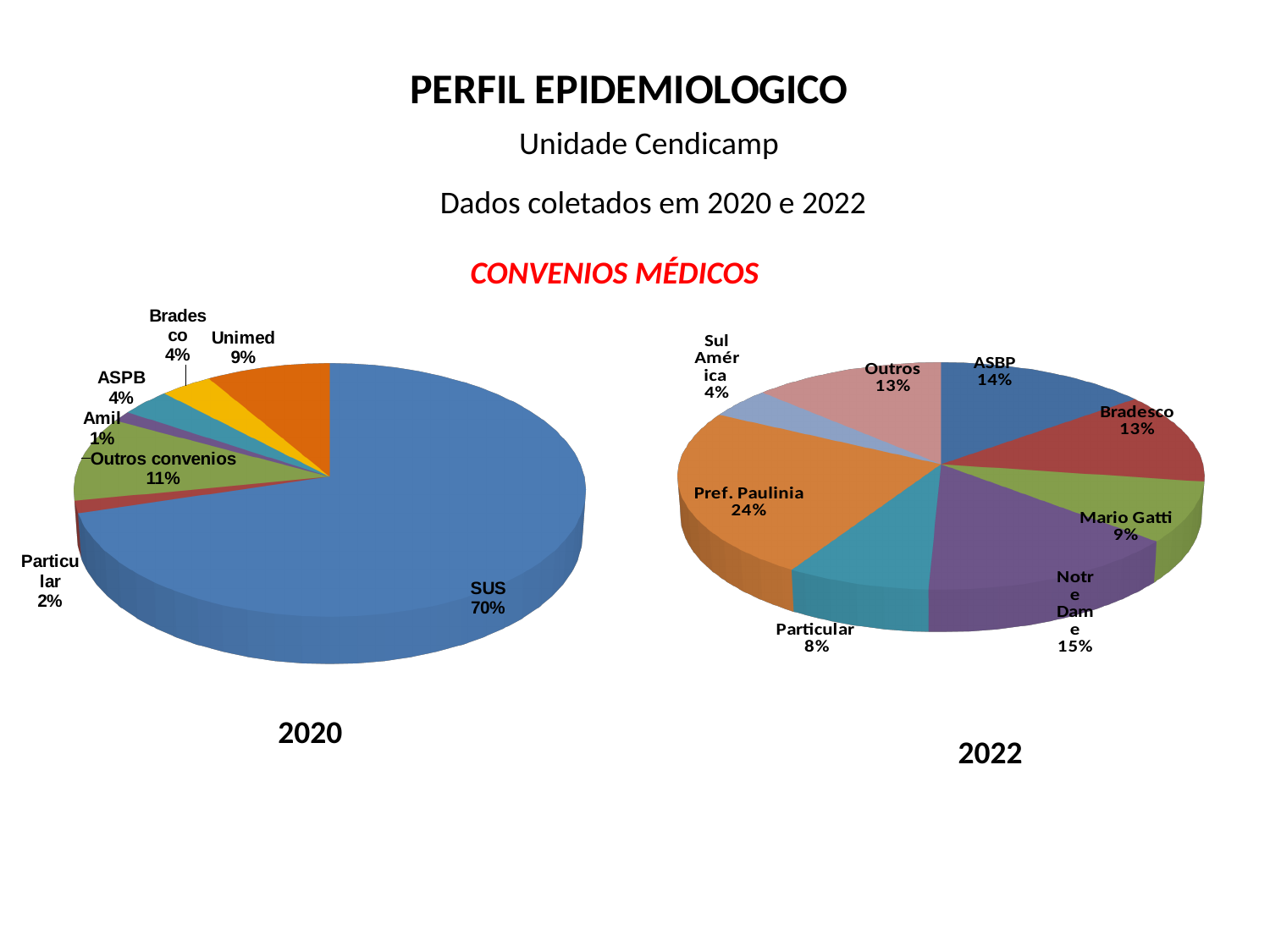
In the 2022 pie chart, which category has the largest share? Pref. Paulinia In the 2020 pie chart, what share does Outros convenios have? 11% In the 2022 pie chart, what share does Pref. Paulinia have? 24% In the 2022 pie chart, how many slices are there? 8 In the 2020 pie chart, what share does SUS have? 70% In the 2022 pie chart, which category has the smallest share? Sul América In the 2020 pie chart, how many slices are there? 7 In the 2022 pie chart, which is larger, ASBP or Mario Gatti? ASBP What kind of chart is used for the 2020 and 2022 data? Pie chart In the 2022 pie chart, what share does Notre Dame have? 15% In the 2020 pie chart, which category has the smallest share? Amil In the 2020 pie chart, what is the difference between the Unimed share and the Bradesco share? 5%